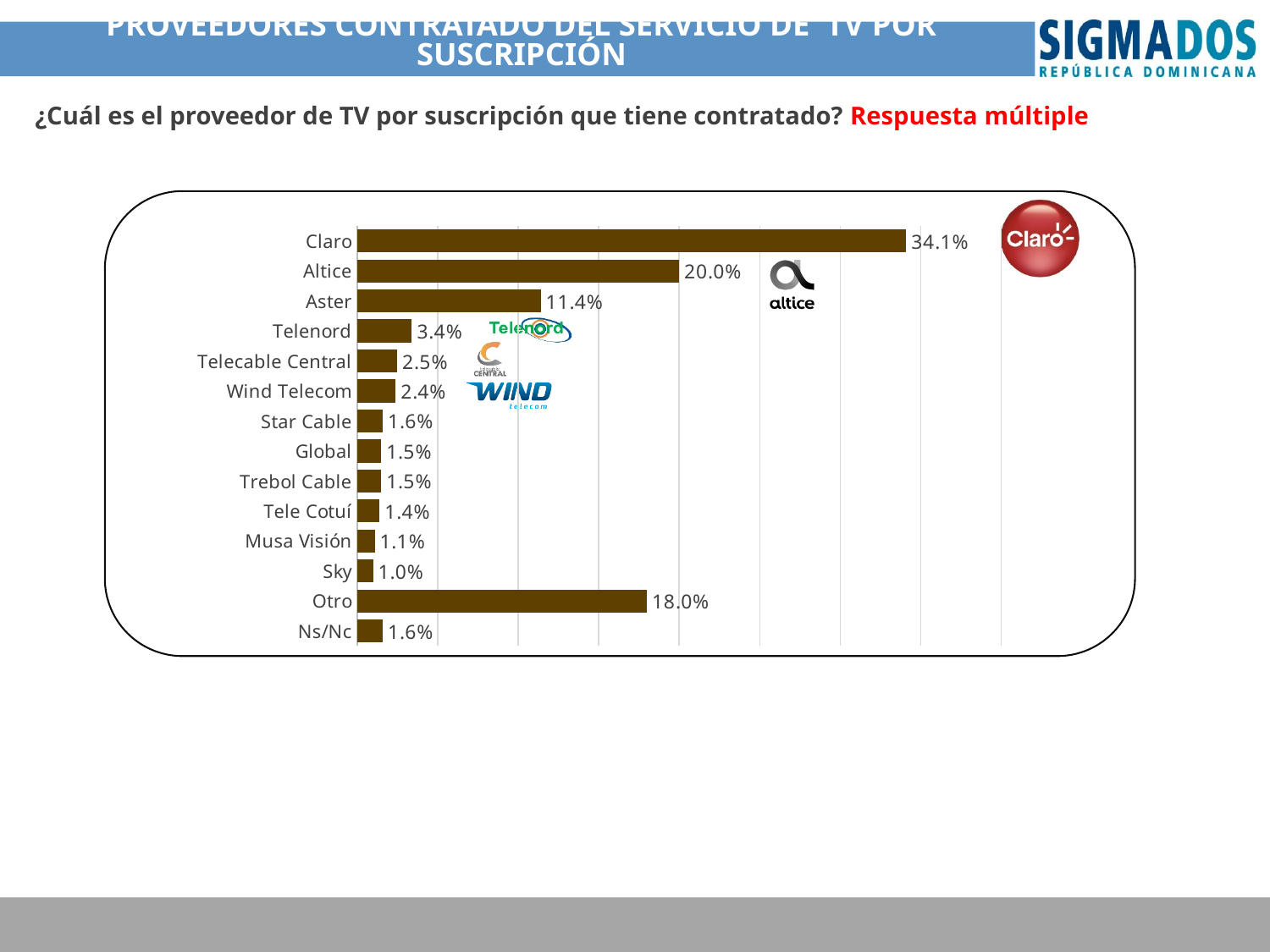
What percentage of respondents have Claro as their subscription TV provider? 34.1% What is the value shown for Altice? 20.0% What is the value shown for Wind Telecom? 2.4% What kind of chart is shown on the slide? Bar chart What is the value shown for Otro? 18.0% Which is larger, the value for Otro or the value for Aster? Otro What is the difference between the values for Telenord and Telecable Central? 0.9% What is the value shown for Aster? 11.4% Which category has the lowest percentage? Sky How many categories are shown in the chart? 14 Which provider has the highest percentage? Claro What is the difference between the values for Claro and Altice? 14.1%